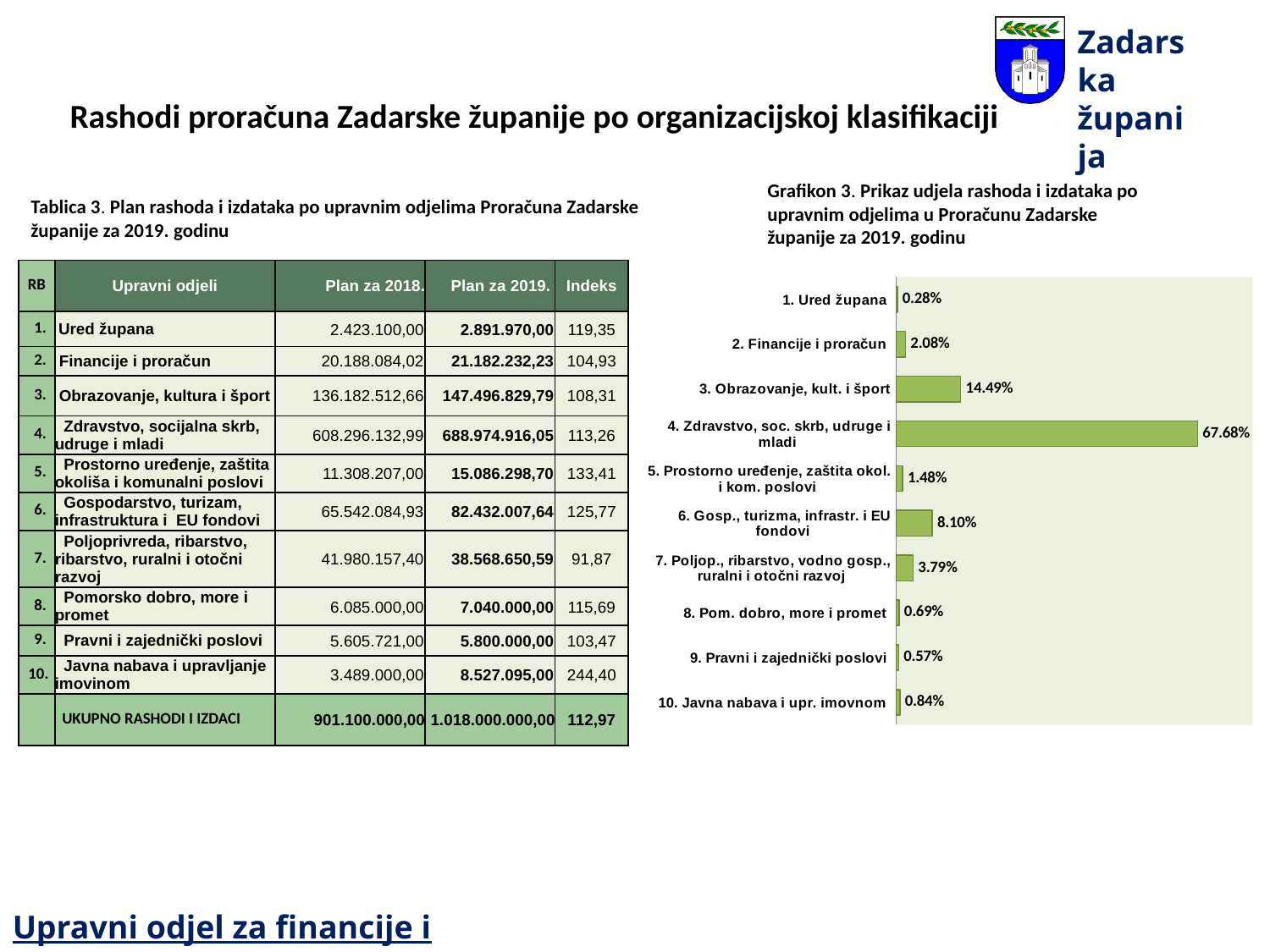
What is the value shown for "6. Gosp., turizma, infrastr. i EU fondovi"? 8.10% What is the value shown for "4. Zdravstvo, soc. skrb, udruge i mladi"? 67.68% What is the difference between the shares of "4. Zdravstvo, soc. skrb, udruge i mladi" and "3. Obrazovanje, kult. i šport"? 53.19% What is the title of the chart on the slide? Grafikon 3. Prikaz udjela rashoda i izdataka po upravnim odjelima u Proračunu Zadarske županije za 2019. godinu Which has a larger share: "2. Financije i proračun" or "5. Prostorno uređenje, zaštita okol. i kom. poslovi"? 2. Financije i proračun What type of chart is shown on the slide? Bar chart Which category has the lowest share in the chart? 1. Ured župana How many categories (upravni odjeli) are plotted in the chart? 10 What is the value shown for "10. Javna nabava i upr. imovnom"? 0.84% Which category has the highest share in the chart? 4. Zdravstvo, soc. skrb, udruge i mladi What is the value shown for "3. Obrazovanje, kult. i šport"? 14.49% What is the difference between the shares of "6. Gosp., turizma, infrastr. i EU fondovi" and "7. Poljop., ribarstvo, vodno gosp., ruralni i otočni razvoj"? 4.31%